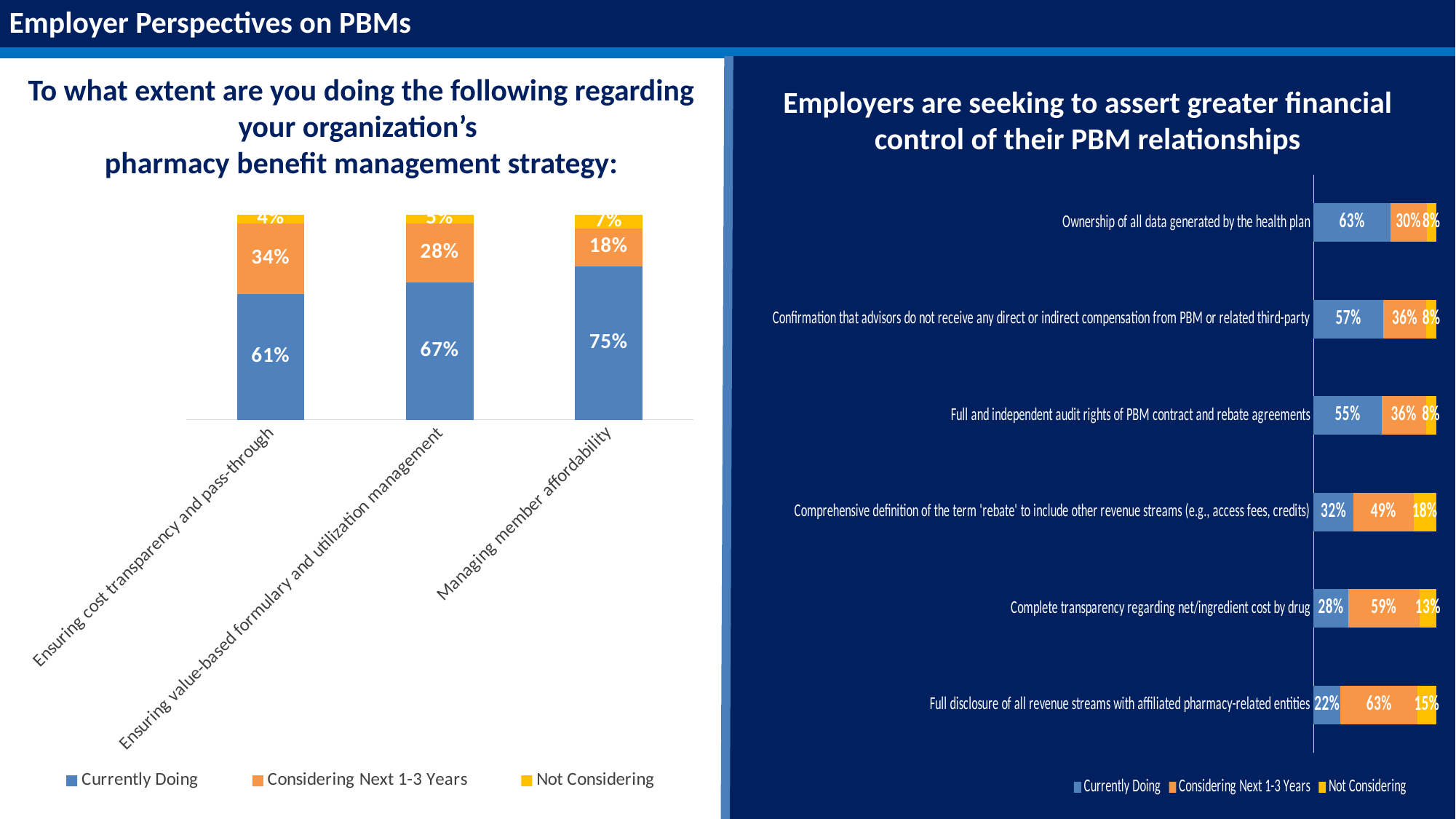
On the right chart, what percentage are 'Not Considering' 'Comprehensive definition of the term rebate to include other revenue streams'? 18% On the right chart, what percentage of employers are currently doing 'Full and independent audit rights of PBM contract and rebate agreements'? 55% On the left chart, what percentage are considering 'Ensuring cost transparency and pass-through' in the next 1-3 years? 34% On the left chart, what percentage of employers are currently doing 'Managing member affordability'? 75% What kind of chart is shown on the right side of the slide? Stacked horizontal bar chart On the right chart, which category has the lowest 'Currently Doing' percentage? Full disclosure of all revenue streams with affiliated pharmacy-related entities On the left chart, which category has the highest 'Currently Doing' percentage? Managing member affordability On the left chart, what is the difference between the 'Currently Doing' percentages for 'Managing member affordability' and 'Ensuring cost transparency and pass-through'? 14% On the right chart, which is larger: the 'Considering Next 1-3 Years' share for 'Complete transparency regarding net/ingredient cost by drug' or for 'Ownership of all data generated by the health plan'? Complete transparency regarding net/ingredient cost by drug On the left chart, how many series does the legend list? 3 On the left chart, how many categories are shown on the x axis? 3 On the right chart, how many categories are listed? 6